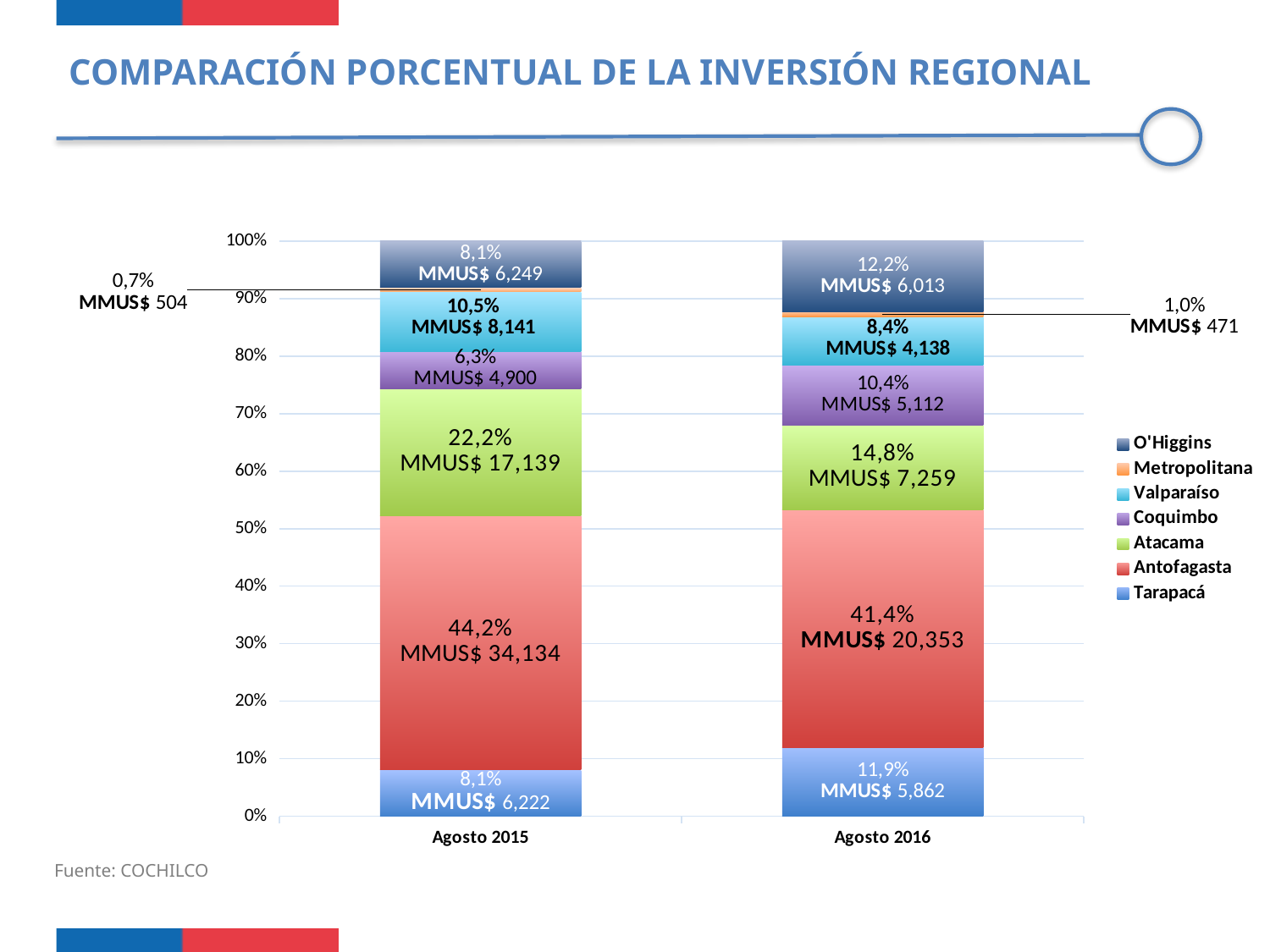
How many categories are shown on the x axis? 2 How many series does the legend list? 7 What type of chart is shown on the slide? Stacked bar chart What is the title of the chart? COMPARACIÓN PORCENTUAL DE LA INVERSIÓN REGIONAL What percentage share does Antofagasta have in Agosto 2015? 44,2% What percentage share does Tarapacá have in Agosto 2016? 11,9% Which region has the smallest share in Agosto 2015? Metropolitana Which is larger: Coquimbo's share in Agosto 2015 or in Agosto 2016? Agosto 2016 What is the investment amount for Metropolitana in Agosto 2015? MMUS$ 504 What is the investment amount for Atacama in Agosto 2016? MMUS$ 7,259 Which region has the largest share in Agosto 2016? Antofagasta What is the difference in percentage points between Antofagasta's share in Agosto 2015 and Agosto 2016? 2,8